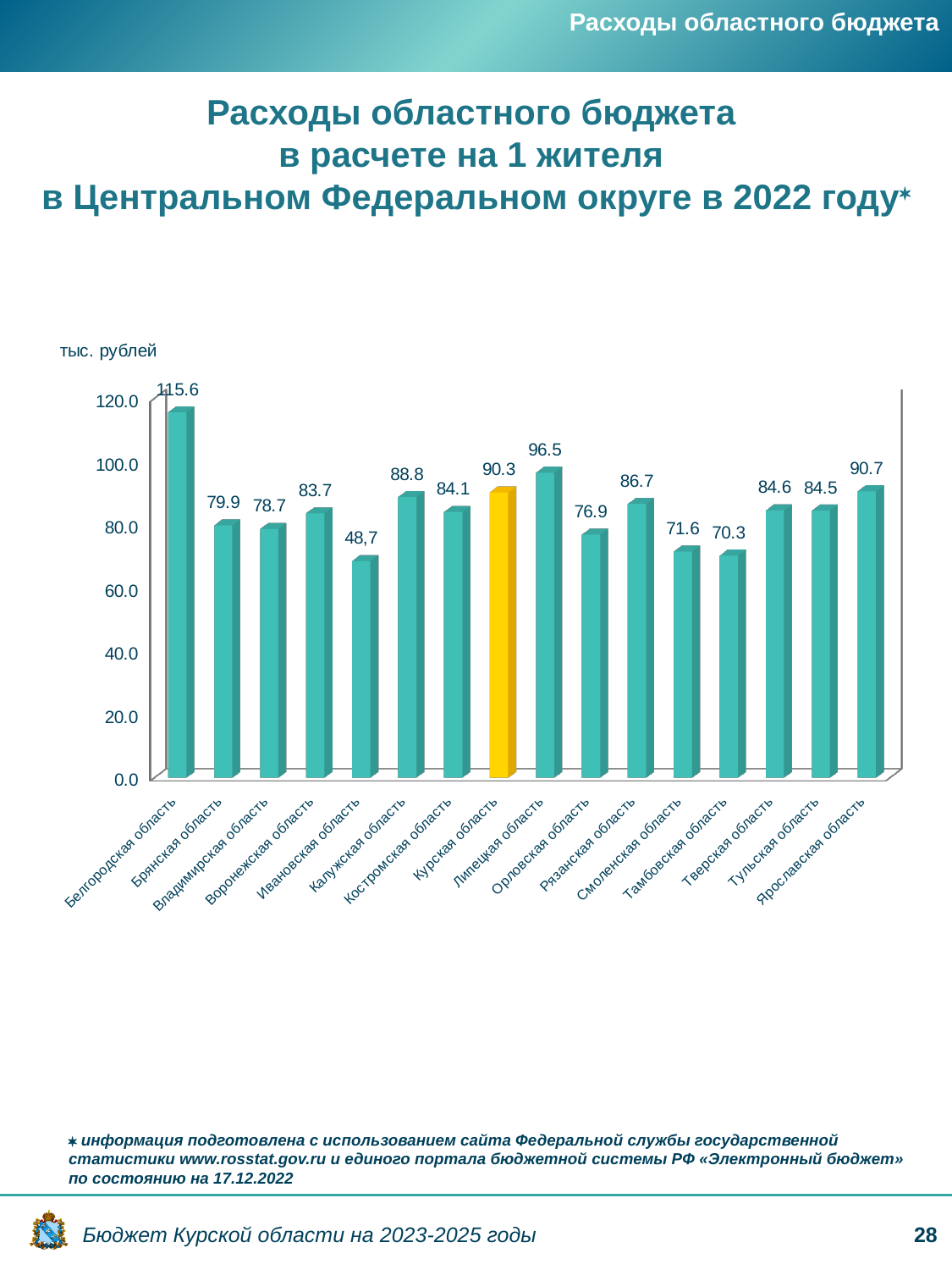
Which is larger, the value for Калужская область or Рязанская область? Калужская область What is the value for Ивановская область? 48,7 What unit is indicated above the vertical axis of the chart? тыс. рублей What is the difference between the values for Белгородская область and Курская область? 25.3 How many regions are shown on the chart? 16 What is the value for Курская область? 90.3 What kind of chart is shown on the slide? Bar chart Which region has the highest value? Белгородская область What is the value for Ярославская область? 90.7 What is the value for Липецкая область? 96.5 What is the difference between the values for Липецкая область and Курская область? 6.2 Which region has the lowest value? Ивановская область